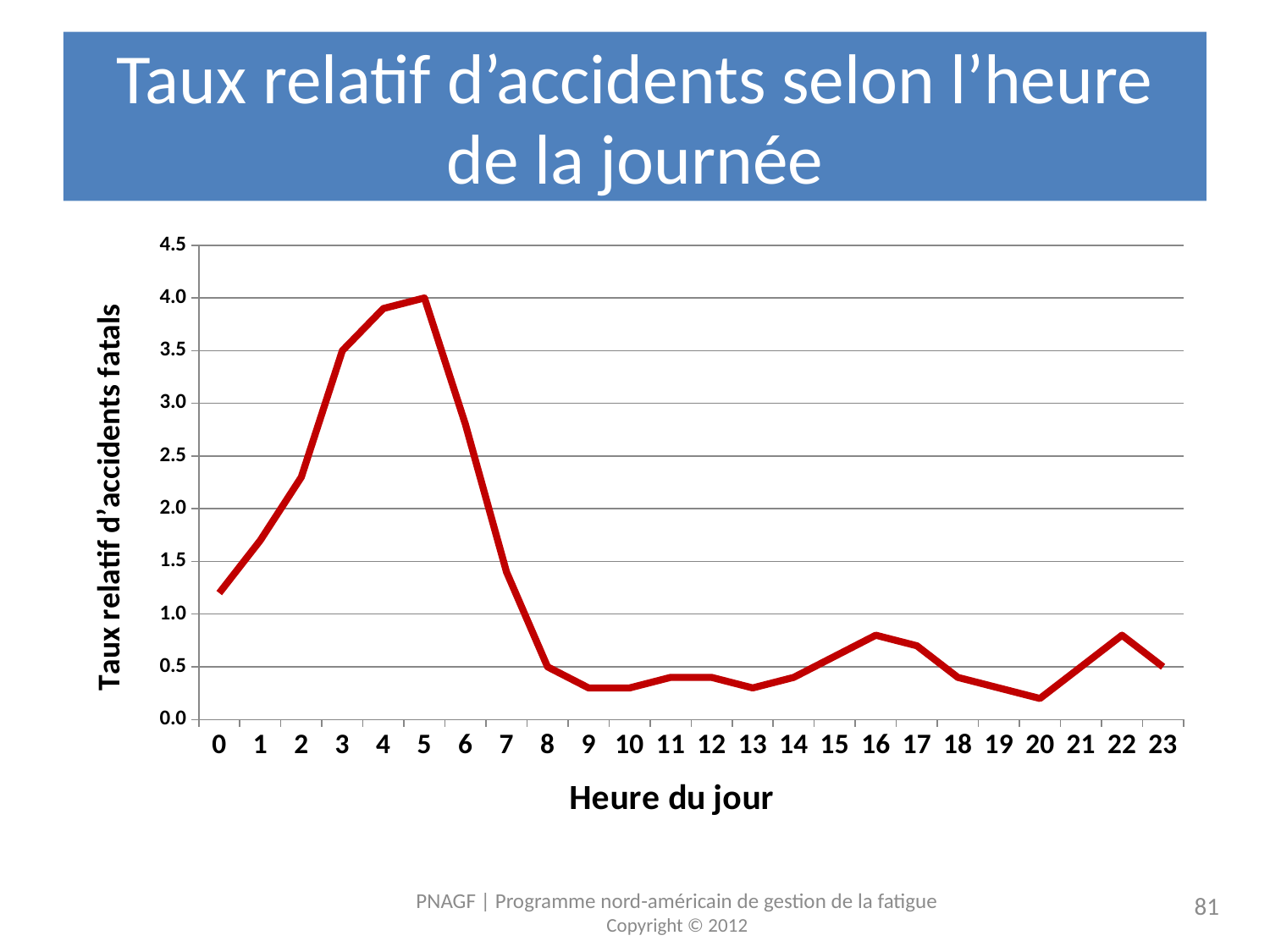
What is the relative rate of fatal accidents at hour 5? 4.0 Is the value for hour 16 greater or less than 0.5? greater How many hours of the day are plotted on the x axis? 24 Does the relative accident rate rise or fall between hour 5 and hour 8? fall What is the relative rate of fatal accidents at hour 8? 0.5 At which hour of the day is the relative rate of fatal accidents lowest? 20 What kind of chart is shown on the slide? line chart Is the value for hour 4 greater or less than 3.5? greater Is the value for hour 2 greater or less than 2.0? greater At which hour of the day does the relative rate of fatal accidents reach its highest value? 5 Which hour has a higher relative accident rate, hour 4 or hour 13? hour 4